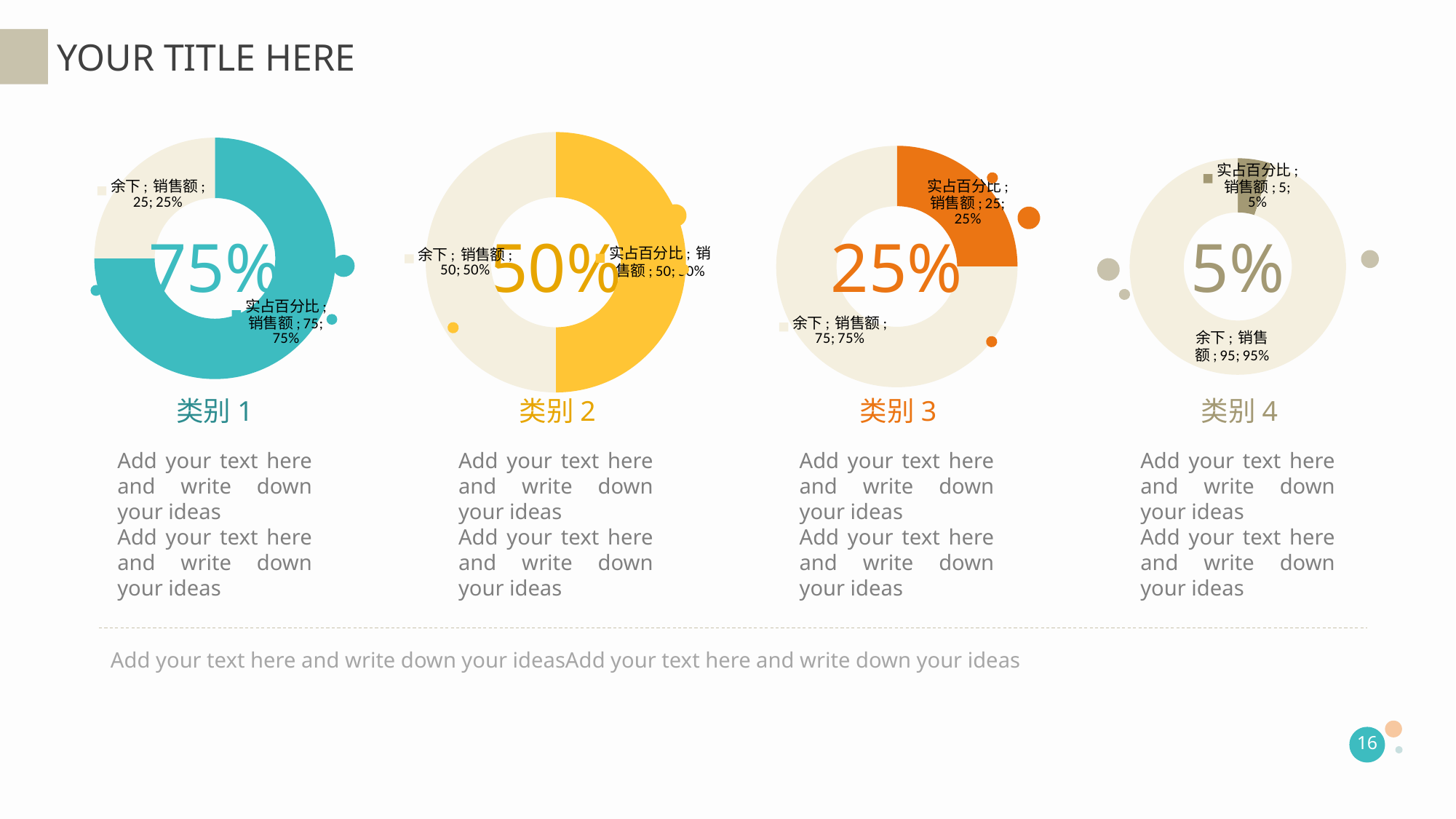
In the 类别 2 chart, what is the value of the 余下 slice? 50 In the 类别 1 chart, what share of the pie does the 余下 slice take? 25% In the 类别 4 chart, what is the value of the 实占百分比 slice? 5 In the 类别 1 chart, what is the value of the 实占百分比 slice? 75 In the 类别 1 chart, what is the difference between the 实占百分比 and 余下 values? 50 How many donut charts are shown on the slide? 4 In the 类别 3 chart, what share of the pie does the 实占百分比 slice take? 25% How many slices does each donut chart on the slide have? 2 In the 类别 4 chart, what share of the pie does the 余下 slice take? 95% In the 类别 3 chart, which slice is larger, 实占百分比 or 余下? 余下 In the 类别 3 chart, what is the value of the 余下 slice? 75 What kind of chart is used for 类别 1? Pie chart (donut)